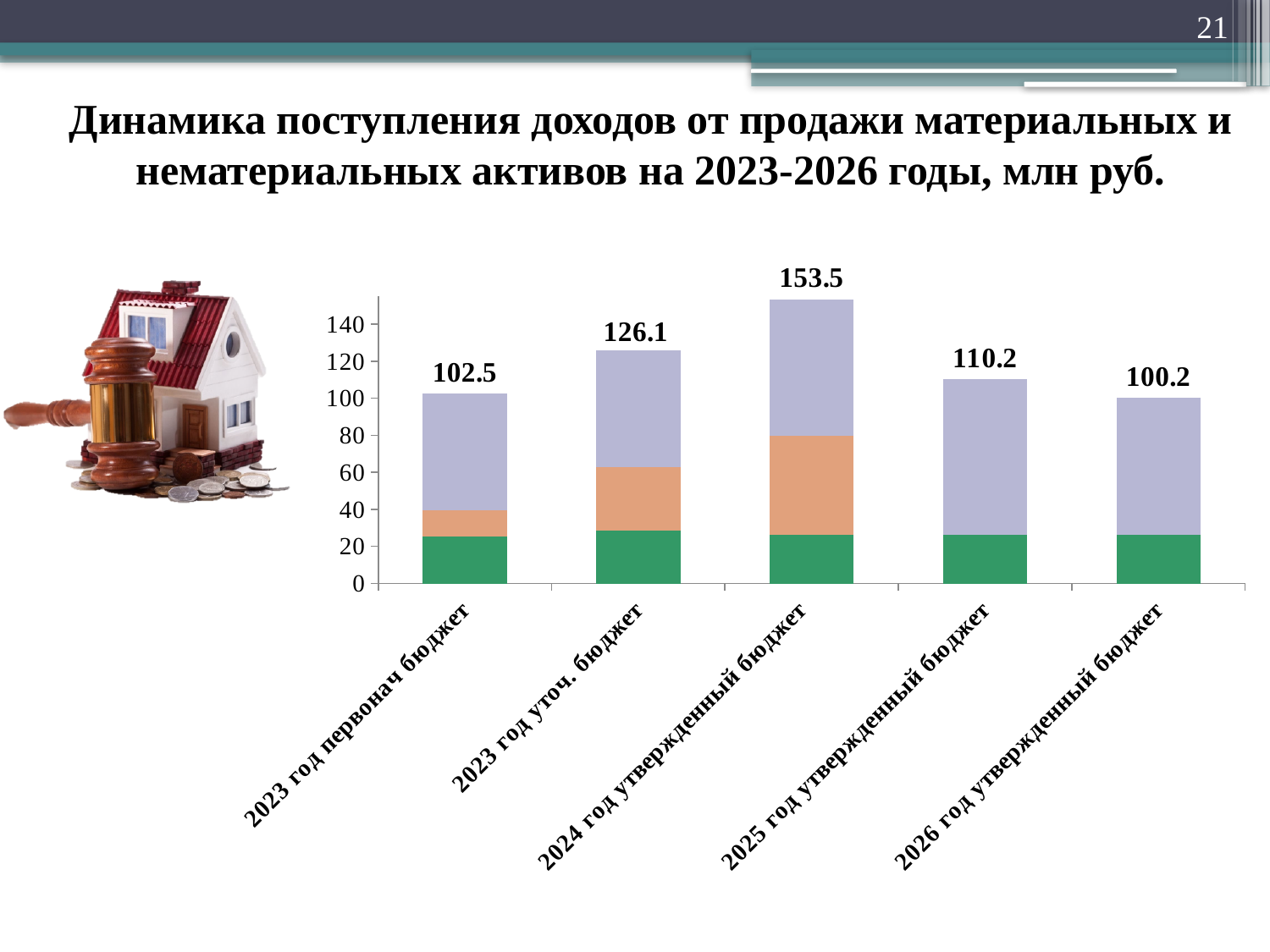
How many bars are shown in the chart? 5 Which category has the lowest total value? 2026 год утвержденный бюджет What is the difference between the totals for "2025 год утвержденный бюджет" and "2026 год утвержденный бюджет"? 10.0 Which category has the highest total value? 2024 год утвержденный бюджет What is the total value shown for the bar labelled "2023 год первонач бюджет"? 102.5 What is the difference between the totals for "2024 год утвержденный бюджет" and "2023 год уточ. бюджет"? 27.4 Which is larger: the total for "2023 год уточ. бюджет" or the total for "2025 год утвержденный бюджет"? 2023 год уточ. бюджет What kind of chart is shown on the slide? Stacked bar chart Do the total values rise or fall from "2024 год утвержденный бюджет" to "2026 год утвержденный бюджет"? fall What is the total value shown for the bar labelled "2024 год утвержденный бюджет"? 153.5 What is the total value shown for the bar labelled "2026 год утвержденный бюджет"? 100.2 Is the green bottom segment of the "2023 год первонач бюджет" bar greater or less than 40? less